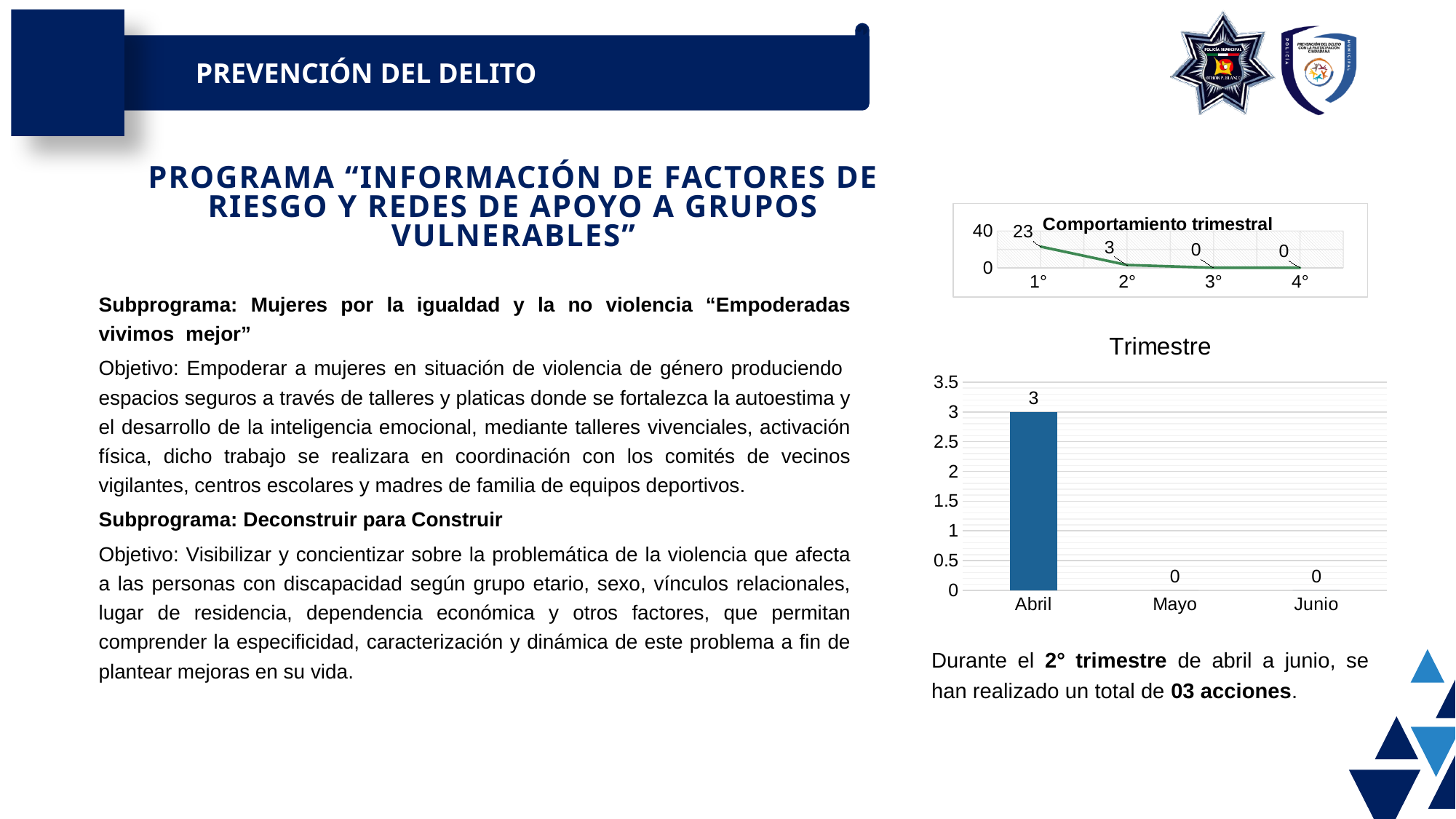
In the "Comportamiento trimestral" chart, what is the value for 1°? 23 What kind of chart is the "Comportamiento trimestral" chart? line chart How many data points are plotted in the "Comportamiento trimestral" chart? 4 In the "Trimestre" chart, what is the value for Abril? 3 In the "Trimestre" chart, what is the value for Mayo? 0 In the "Comportamiento trimestral" chart, which quarter has the highest value? 1° How many categories are shown in the "Trimestre" chart? 3 What kind of chart is the "Trimestre" chart? bar chart In the "Comportamiento trimestral" chart, what is the value for 2°? 3 In the "Comportamiento trimestral" chart, do the values rise or fall from 1° to 4°? fall In the "Trimestre" chart, which month has the highest value? Abril In the "Comportamiento trimestral" chart, what is the difference between the values for 1° and 2°? 20